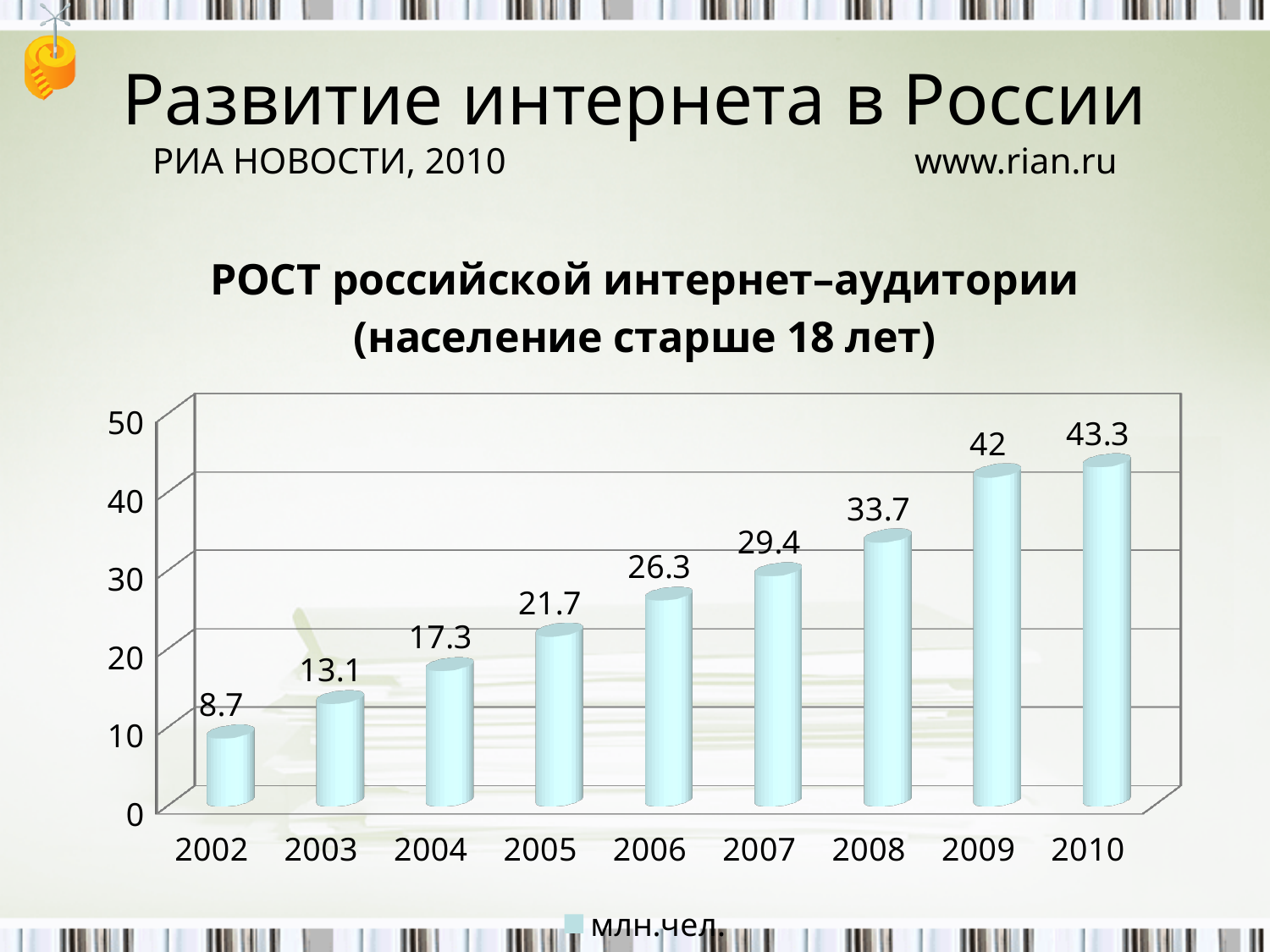
What is the difference between the values for 2009 and 2008? 8.3 Which is larger, the value for 2005 or the value for 2007? 2007 What is the value for 2002? 8.7 What kind of chart is shown on the slide? bar chart Do the values rise or fall from 2002 to 2010? rise Which year has the highest value? 2010 Which year has the lowest value? 2002 What is the difference between the values for 2010 and 2002? 34.6 How many years are shown on the x axis? 9 Is the value for 2008 greater or less than 30? greater What is the value for 2006? 26.3 What is the value for 2010? 43.3